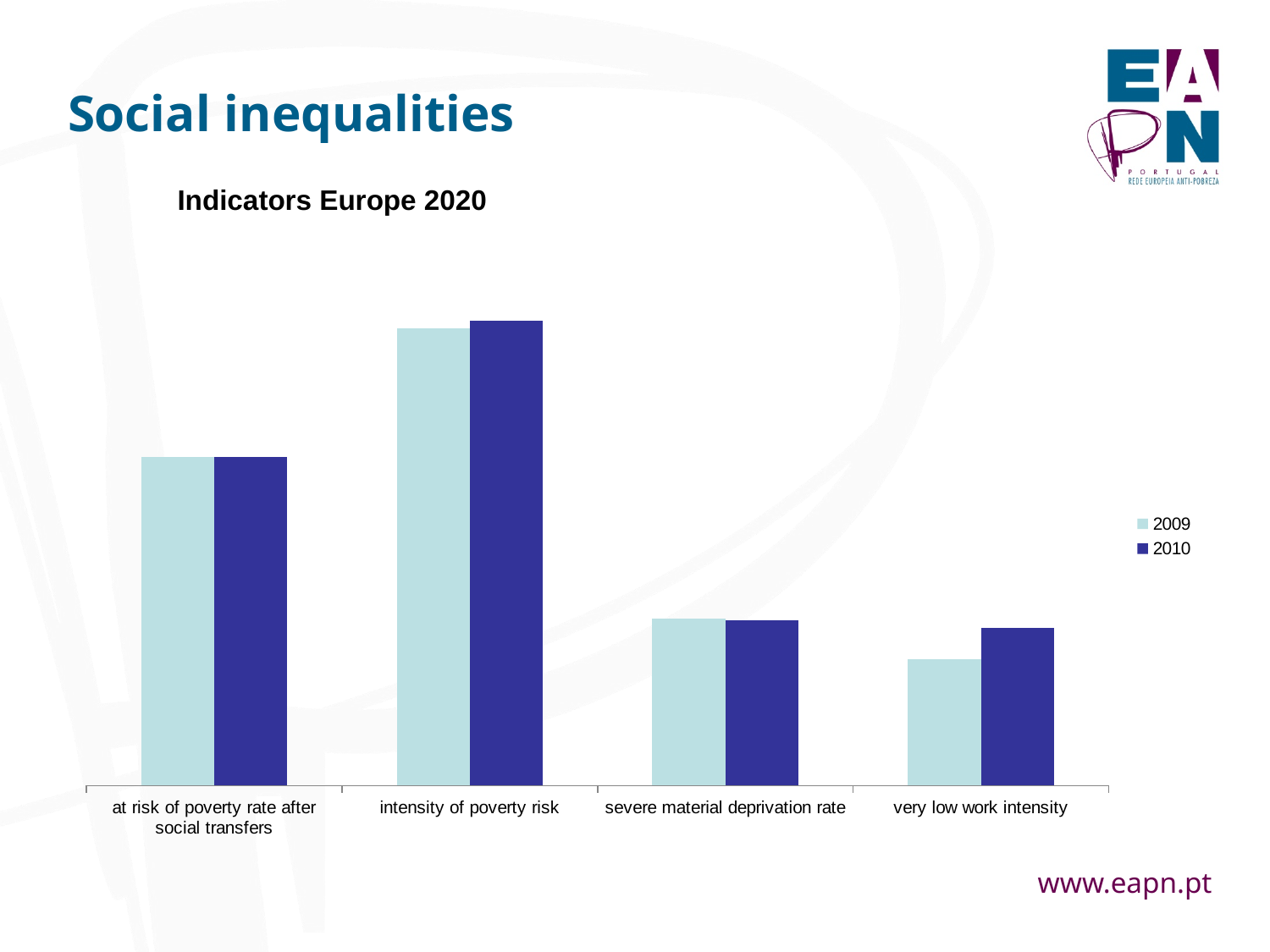
What kind of chart is shown on the slide? bar chart Did the value for very low work intensity rise or fall from 2009 to 2010? rise Which category has the highest value for 2010? intensity of poverty risk Which category has the highest value for 2009? intensity of poverty risk For 2009, which is larger: at risk of poverty rate after social transfers or severe material deprivation rate? at risk of poverty rate after social transfers Which years are listed in the chart's legend? 2009 and 2010 How many categories are shown on the x axis of the chart? 4 Which category has the lowest value for 2009? very low work intensity What is the title shown above the chart? Indicators Europe 2020 For very low work intensity, which year has the larger value, 2009 or 2010? 2010 For 2010, which is larger: intensity of poverty risk or at risk of poverty rate after social transfers? intensity of poverty risk How many series does the chart's legend list? 2